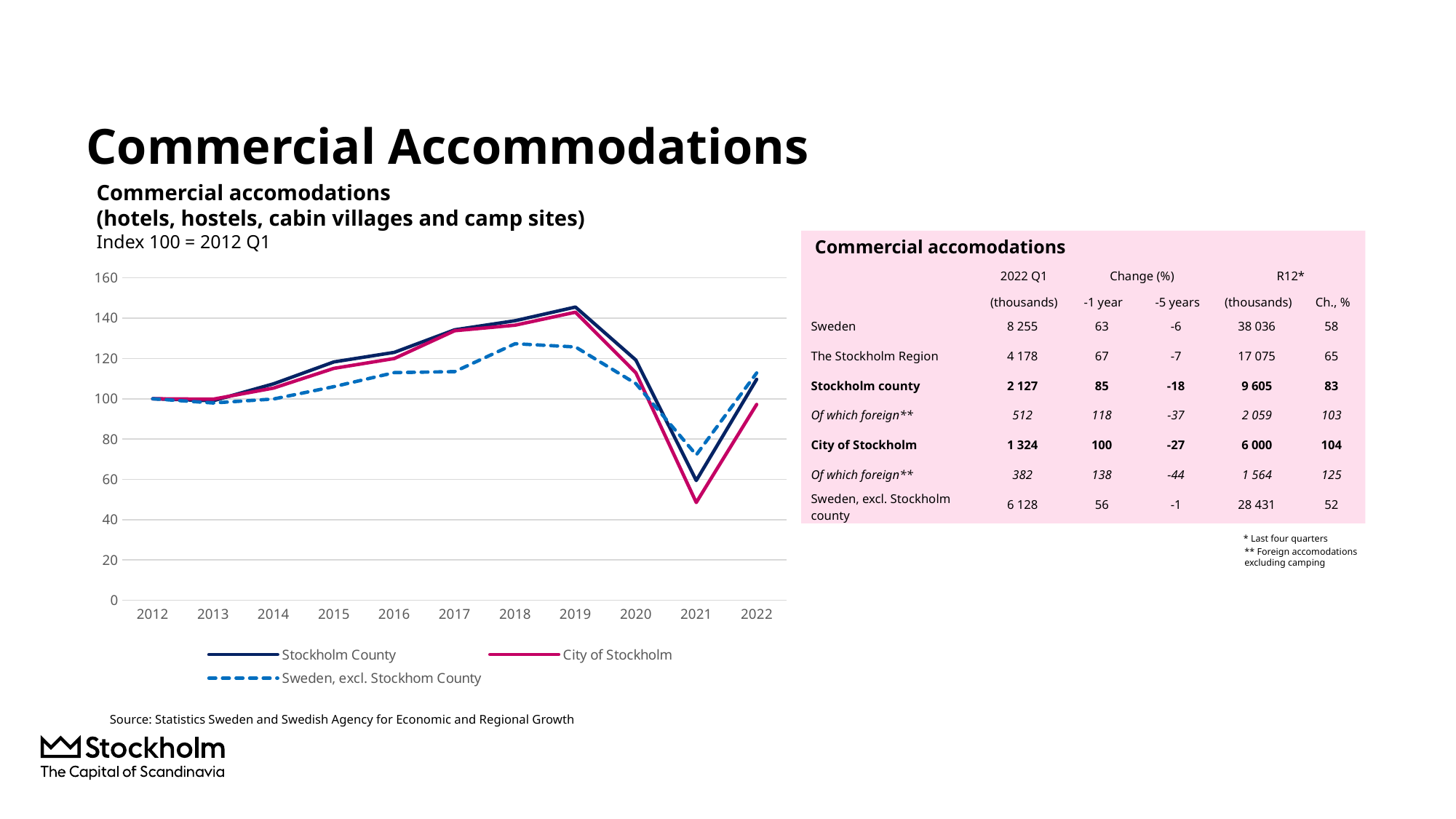
Which series is drawn with a dashed line in the chart? Sweden, excl. Stockhom County Is the value for Sweden, excl. Stockhom County in 2019 greater or less than 140? less What kind of chart is shown on the slide? line chart In which year does the City of Stockholm line reach its lowest value? 2021 Is the value for Stockholm County in 2019 greater or less than 140? greater In 2019, which is larger: Stockholm County or Sweden, excl. Stockhom County? Stockholm County Is the value for City of Stockholm in 2021 greater or less than 60? less How many years are shown on the x axis of the chart? 11 How many series does the chart legend list? 3 Does the Stockholm County line rise or fall between 2019 and 2021? fall Which series has the lowest value in 2021? City of Stockholm Which series has the highest value in 2021? Sweden, excl. Stockhom County